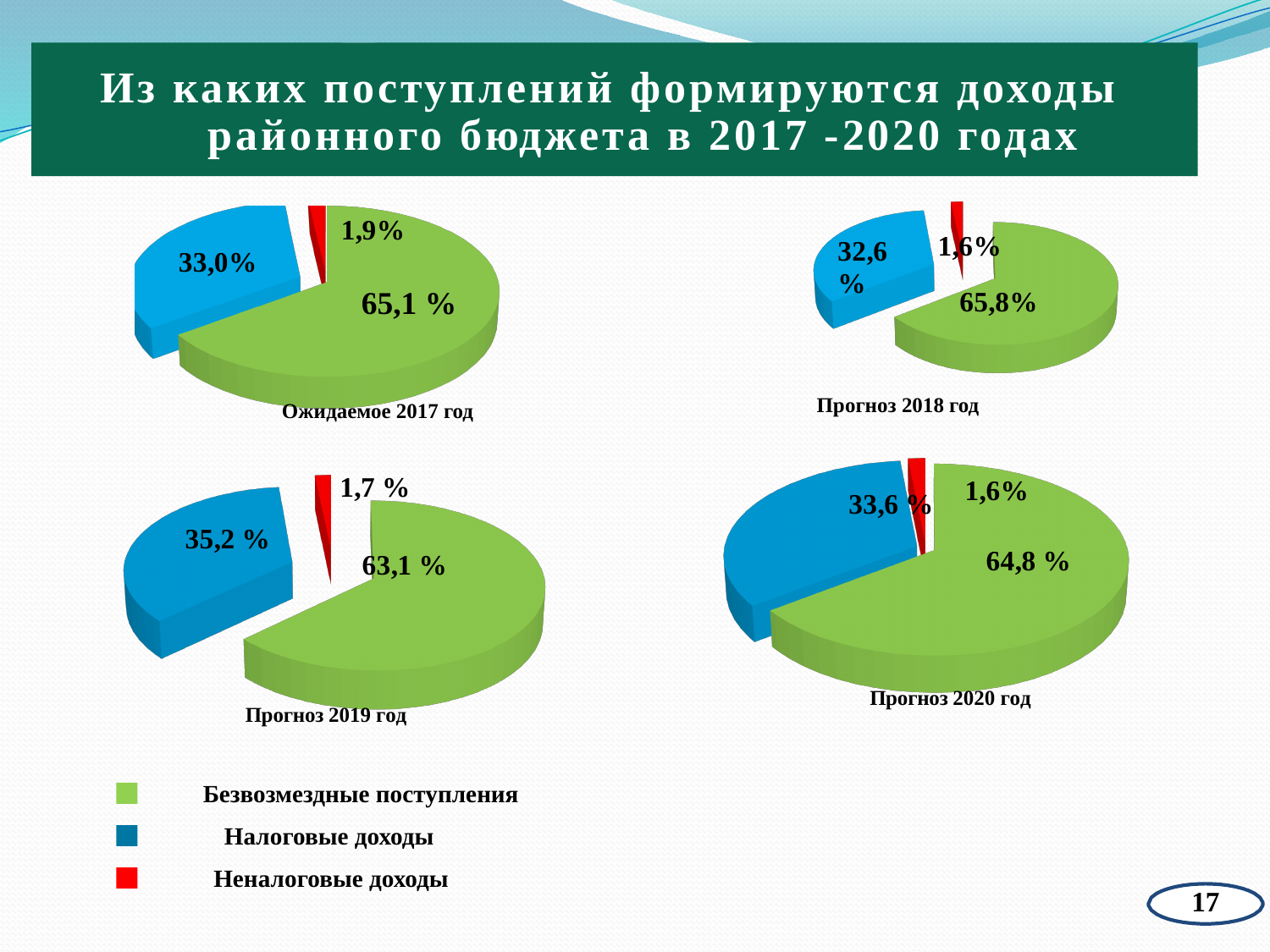
In the chart titled "Прогноз 2019 год", which category has the largest slice? Безвозмездные поступления What type of chart is used on this slide? Pie chart In the chart titled "Ожидаемое 2017 год", what share is shown for Безвозмездные поступления (green slice)? 65,1 % How many pie charts are shown on the slide? 4 In the chart titled "Ожидаемое 2017 год", which category has the smallest slice? Неналоговые доходы In the chart titled "Прогноз 2020 год", what share is shown for Безвозмездные поступления (green slice)? 64,8 % According to the legend, which category is shown in red? Неналоговые доходы How many slices does the chart titled "Прогноз 2018 год" have? 3 Which is larger: the share of Налоговые доходы in the chart "Прогноз 2019 год" or in the chart "Прогноз 2018 год"? Прогноз 2019 год In the chart titled "Прогноз 2019 год", what share is shown for Неналоговые доходы (red slice)? 1,7 % In the chart titled "Прогноз 2018 год", what share is shown for Налоговые доходы (blue slice)? 32,6 % In the chart titled "Прогноз 2020 год", what is the difference between the shares of Безвозмездные поступления and Налоговые доходы? 31,2 %